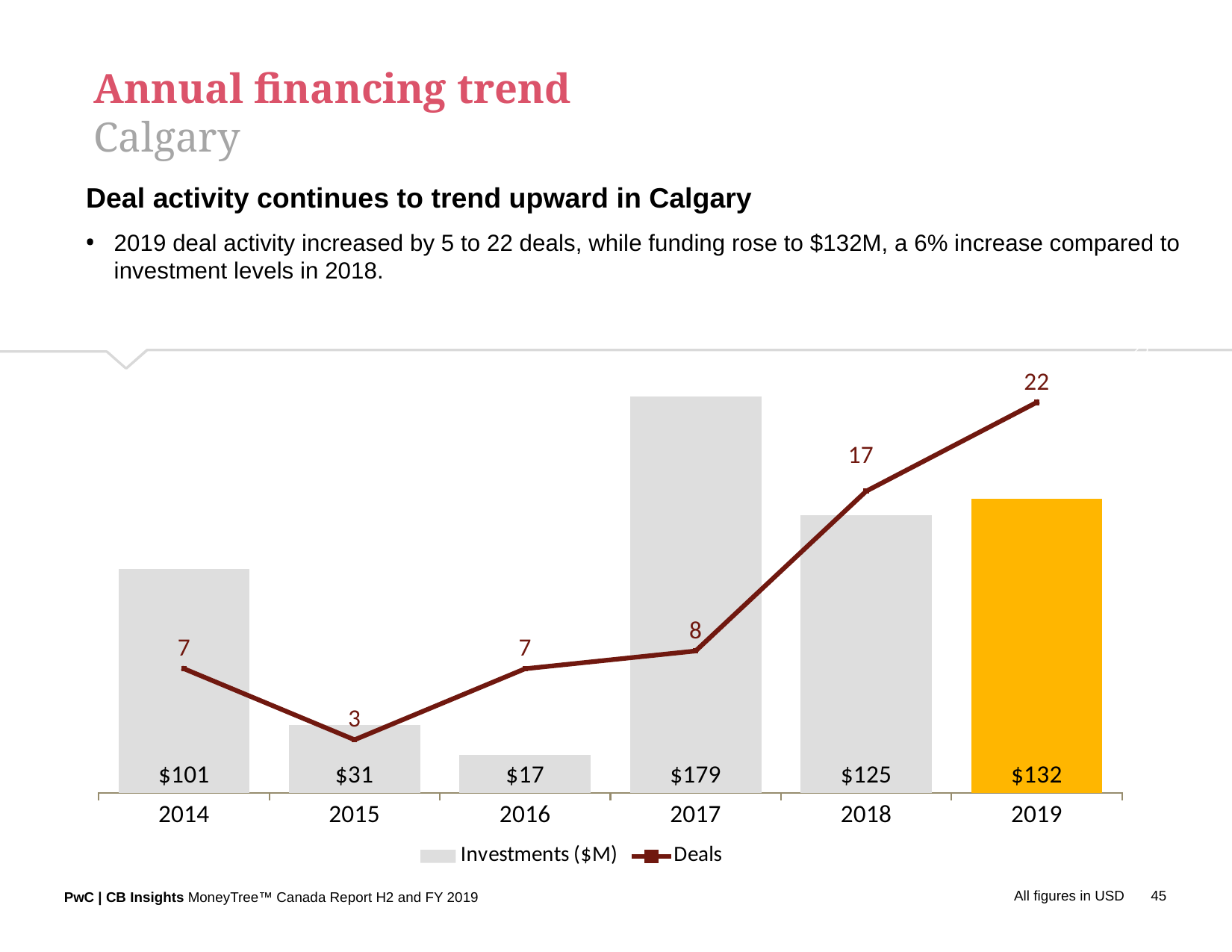
What is the Investments ($M) value for 2017? $179 What is the difference in deals between 2019 and 2018? 5 Which year has the highest number of deals? 2019 What is the Investments ($M) value for 2019? $132 Which year has the lowest Investments ($M) value? 2016 How many series does the legend list? 2 Do the number of deals rise or fall from 2015 to 2019? rise Which year had more deals, 2014 or 2017? 2017 How many years are shown on the x axis? 6 What is the difference in Investments ($M) between 2017 and 2018? $54 How many deals were recorded in 2015? 3 Which year has the highest Investments ($M) value? 2017